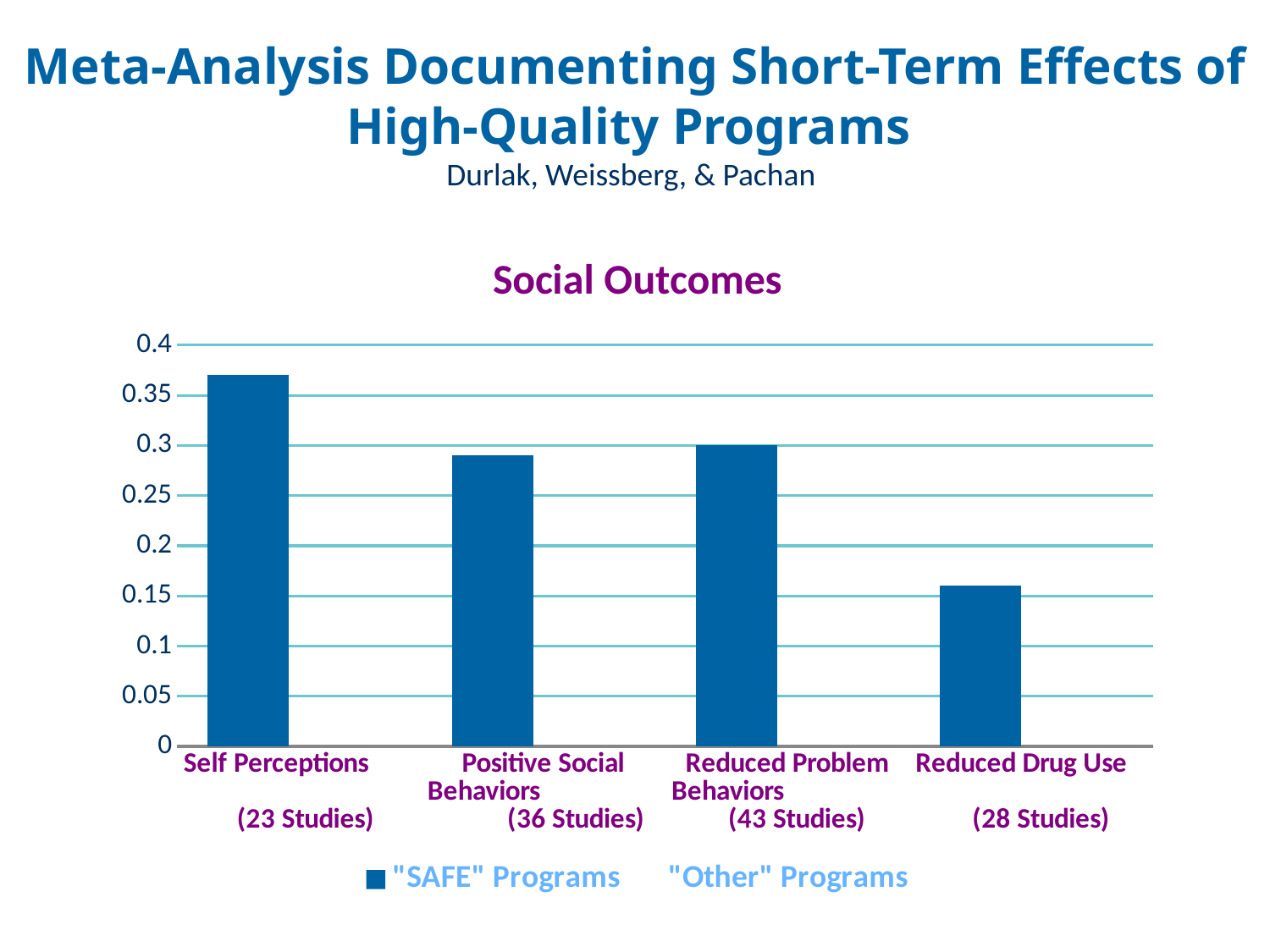
What is the title of the chart? Social Outcomes Which category has the highest bar in the chart? Self Perceptions Is the value for Positive Social Behaviors greater or less than 0.25? greater What kind of chart is shown on the slide? bar chart How many series does the chart's legend list? 2 Is the value for Reduced Problem Behaviors greater or less than 0.35? less Is the value for Reduced Drug Use greater or less than 0.2? less Which is larger, the value for Self Perceptions or the value for Reduced Drug Use? Self Perceptions How many studies are listed under the Reduced Problem Behaviors category? 43 Studies How many categories are shown on the x axis of the chart? 4 Which category has the lowest bar in the chart? Reduced Drug Use